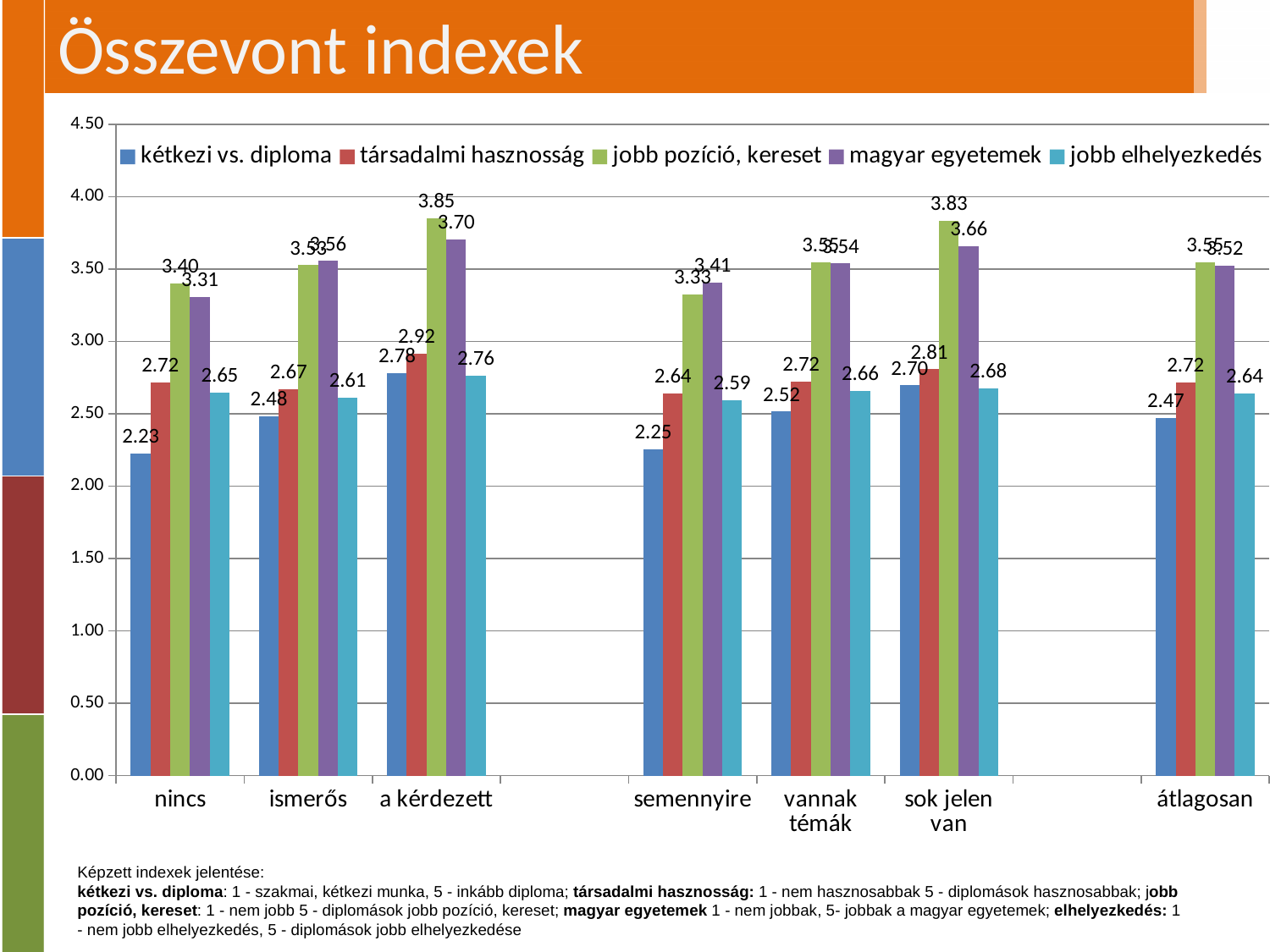
Is the value of jobb elhelyezkedés for the category átlagosan greater or less than 3.00? less What is the value of társadalmi hasznosság for the category sok jelen van? 2.81 Which is larger for the category nincs: jobb pozíció, kereset or magyar egyetemek? jobb pozíció, kereset Which category has the lowest value for jobb pozíció, kereset? semennyire What is the value of jobb pozíció, kereset for the category a kérdezett? 3.85 What is the value of magyar egyetemek for the category semennyire? 3.41 What type of chart is shown on the slide? bar chart How many series does the legend list? 5 What is the difference between the jobb pozíció, kereset value and the kétkezi vs. diploma value for the category a kérdezett? 1.07 What is the value of kétkezi vs. diploma for the category nincs? 2.23 How many categories are shown on the x axis? 7 Which category has the highest value for kétkezi vs. diploma? a kérdezett